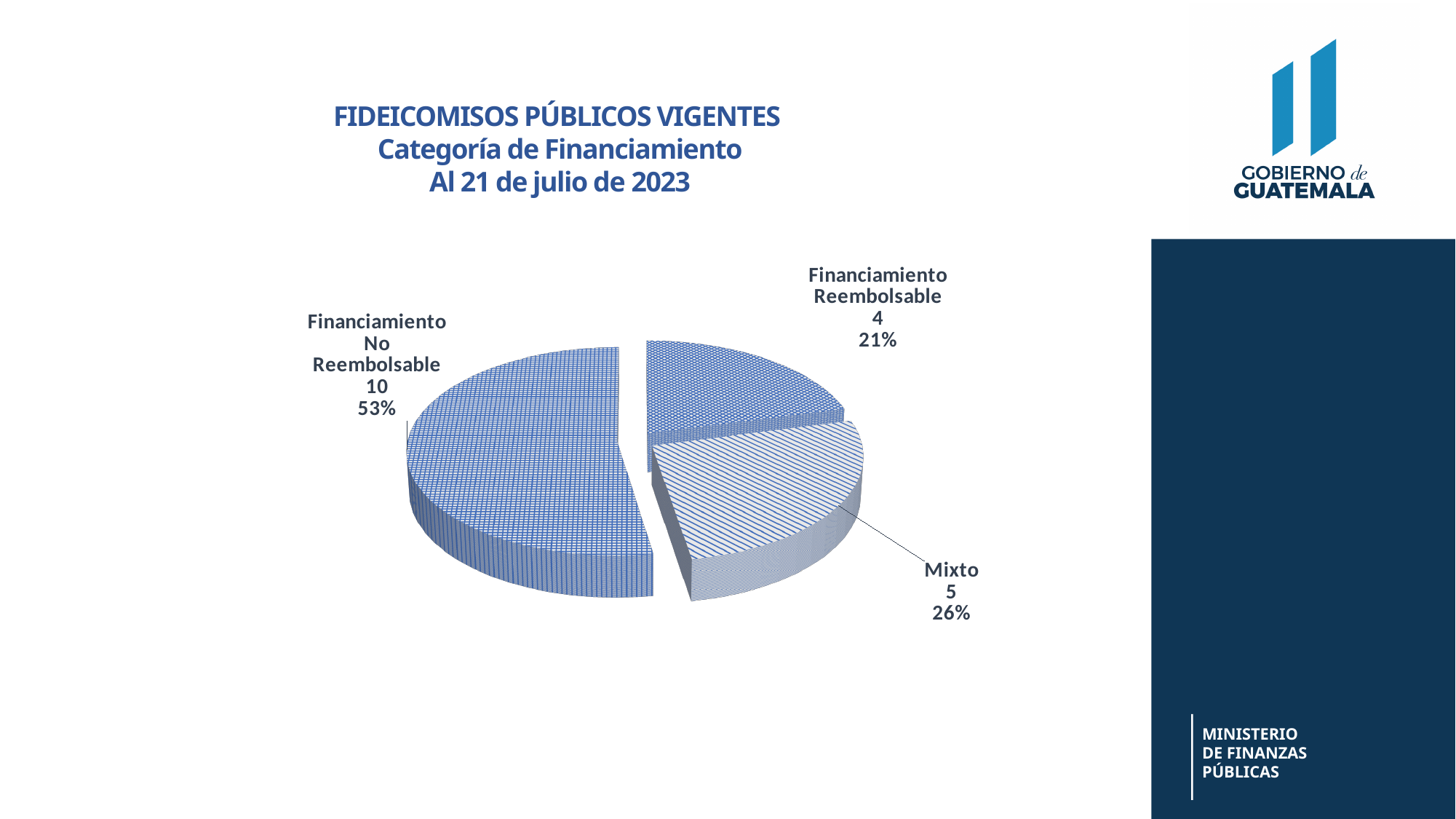
How many categories does the pie chart show? 3 What is the difference in count between Financiamiento No Reembolsable and Mixto? 5 Which has more fideicomisos, Mixto or Financiamiento Reembolsable? Mixto How many fideicomisos are in the Mixto category? 5 What percentage share does the Financiamiento Reembolsable slice have? 21% What kind of chart is shown on the slide? Pie chart What percentage share does the Mixto slice have? 26% Which category has the smallest slice of the pie? Financiamiento Reembolsable How many fideicomisos are in the Financiamiento No Reembolsable category? 10 What percentage share does the Financiamiento No Reembolsable slice have? 53% How many fideicomisos are in the Financiamiento Reembolsable category? 4 Which category has the largest slice of the pie? Financiamiento No Reembolsable